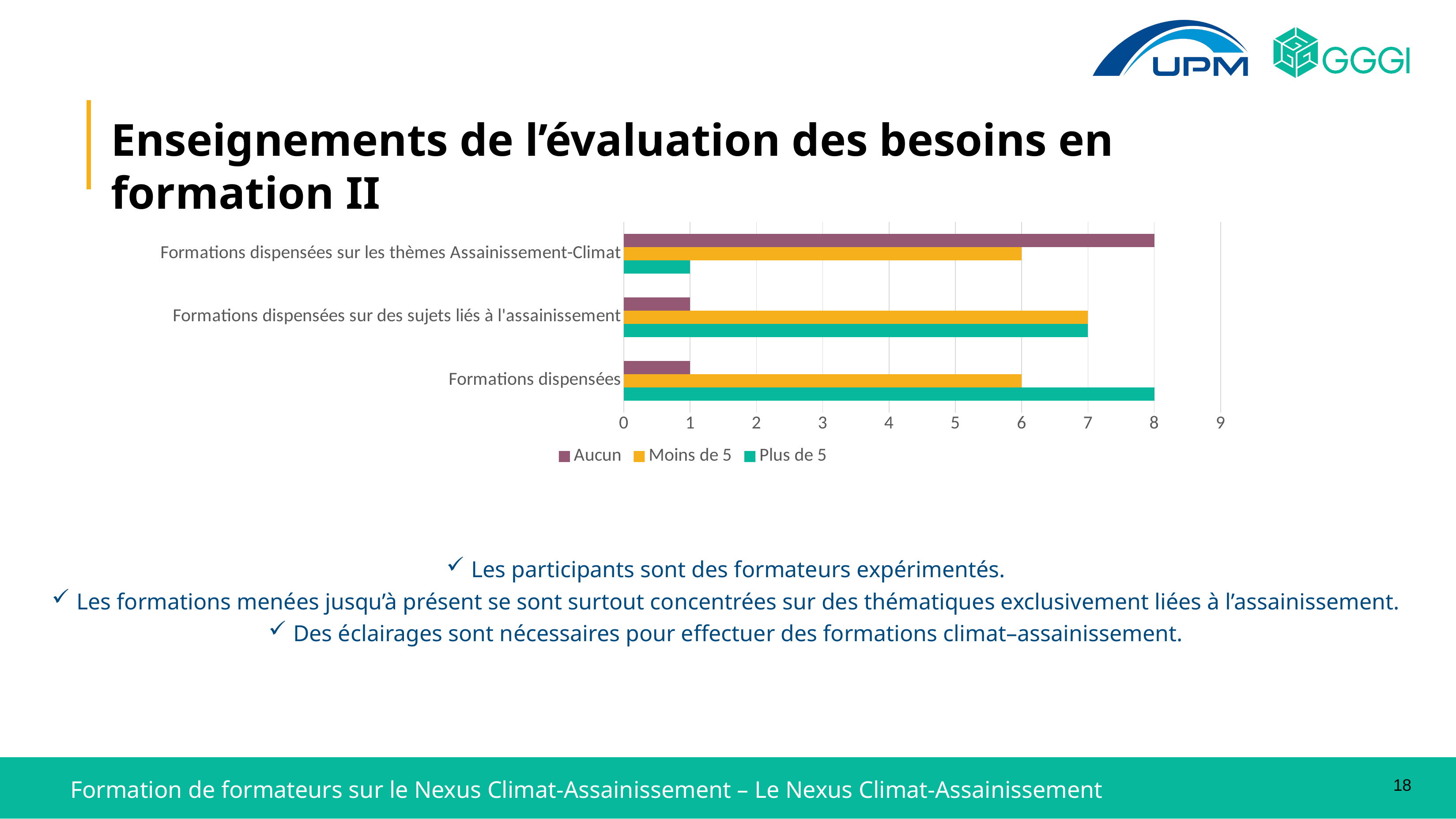
Which category has the highest value for the 'Aucun' series? Formations dispensées sur les thèmes Assainissement-Climat How many categories are shown on the chart? 3 What is the difference between the 'Plus de 5' and 'Aucun' values for 'Formations dispensées'? 7 For 'Formations dispensées sur les thèmes Assainissement-Climat', which is larger: the 'Aucun' value or the 'Moins de 5' value? Aucun What is the value of the 'Moins de 5' series for 'Formations dispensées sur des sujets liés à l'assainissement'? 7 What kind of chart is shown on the slide? Bar chart What is the value of the 'Plus de 5' series for 'Formations dispensées sur les thèmes Assainissement-Climat'? 1 Which category has the lowest value for the 'Plus de 5' series? Formations dispensées sur les thèmes Assainissement-Climat How many series does the legend list? 3 What is the value of the 'Plus de 5' series for 'Formations dispensées'? 8 What is the value of the 'Aucun' series for 'Formations dispensées sur les thèmes Assainissement-Climat'? 8 Which series is shown in purple in the legend? Aucun